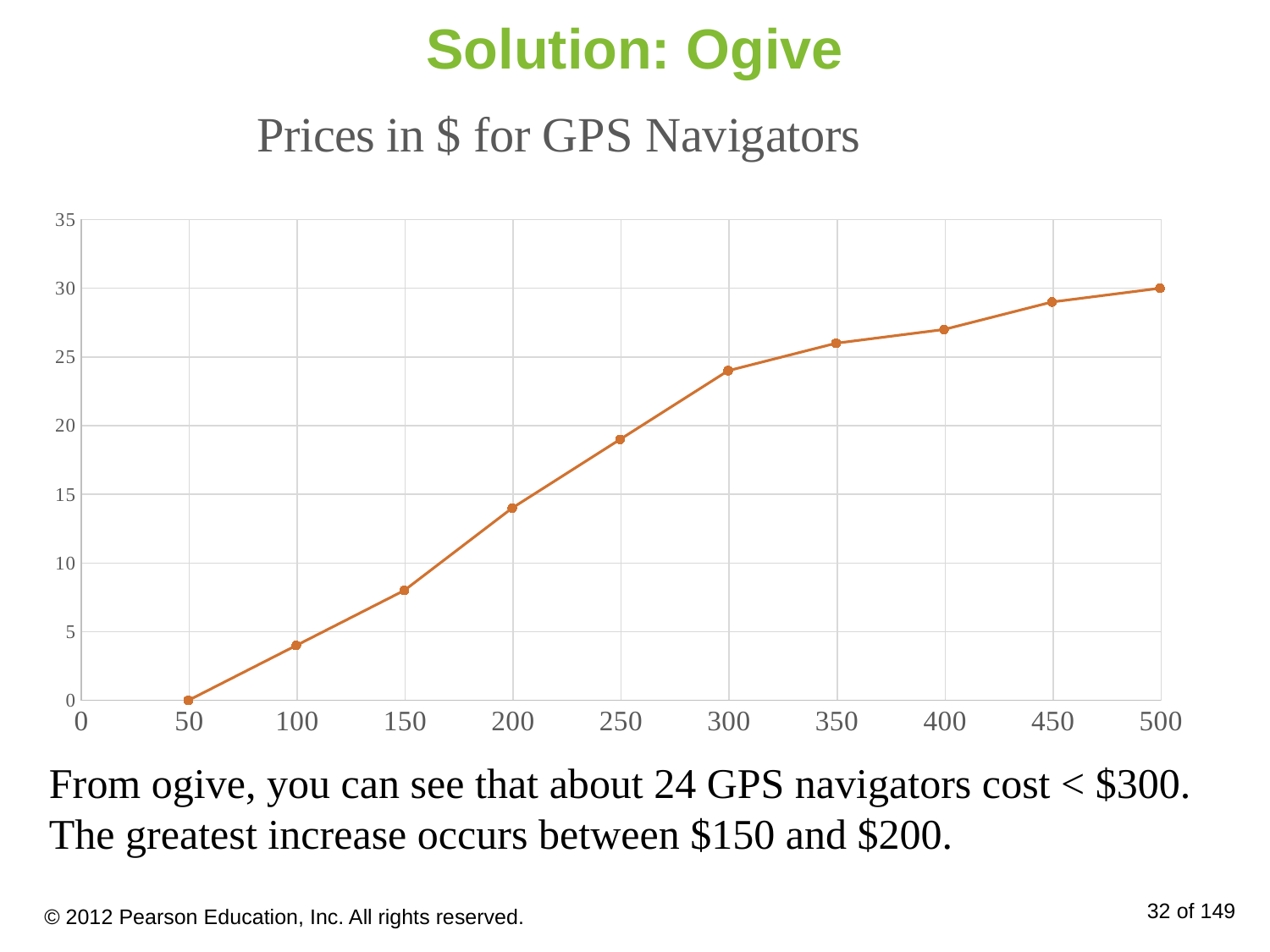
What is the cumulative frequency value plotted at 50? 0 Is the value plotted at 200 greater or less than 10? greater At which x-axis value is the plotted value highest? 500 What kind of chart is shown on the slide? line chart How many data points are plotted on the line? 10 Which has the larger plotted value, 200 or 400? 400 At which x-axis value is the plotted value lowest? 50 What is the title of the chart? Prices in $ for GPS Navigators Do the plotted values rise or fall as the x-axis values increase? rise Is the value plotted at 150 greater or less than 10? less What is the cumulative frequency value plotted at 500? 30 Is the value plotted at 400 greater or less than 30? less